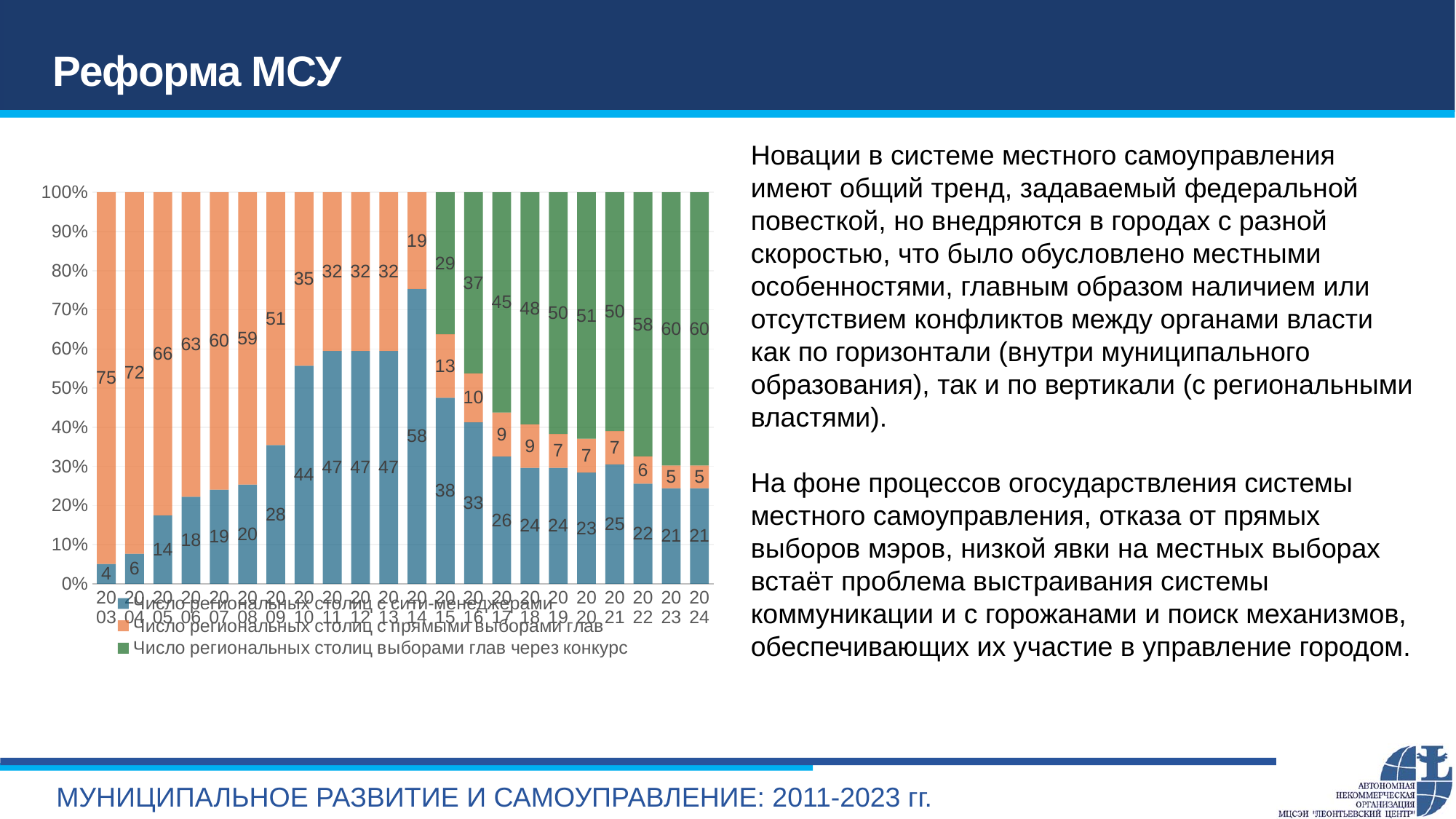
How many years are shown on the x axis of the chart? 22 In which year is the value for 'Число региональных столиц с сити-менеджерами' the lowest? 2003 Does the value for 'Число региональных столиц с прямыми выборами глав' rise or fall from 2003 to 2024? Fall How many series does the chart legend list? 3 Which is larger in 2010: the value for 'Число региональных столиц с сити-менеджерами' or for 'Число региональных столиц с прямыми выборами глав'? Число региональных столиц с сити-менеджерами What is the value for 'Число региональных столиц выборами глав через конкурс' in 2017? 45 What is the value for 'Число региональных столиц с сити-менеджерами' in 2014? 58 In which year is the value for 'Число региональных столиц с прямыми выборами глав' the highest? 2003 What is the difference between the 'Число региональных столиц выборами глав через конкурс' values in 2024 and 2015? 31 What colour represents 'Число региональных столиц выборами глав через конкурс' in the chart? Green What is the value for 'Число региональных столиц с прямыми выборами глав' in 2003? 75 What kind of chart is shown on the slide? Stacked bar chart